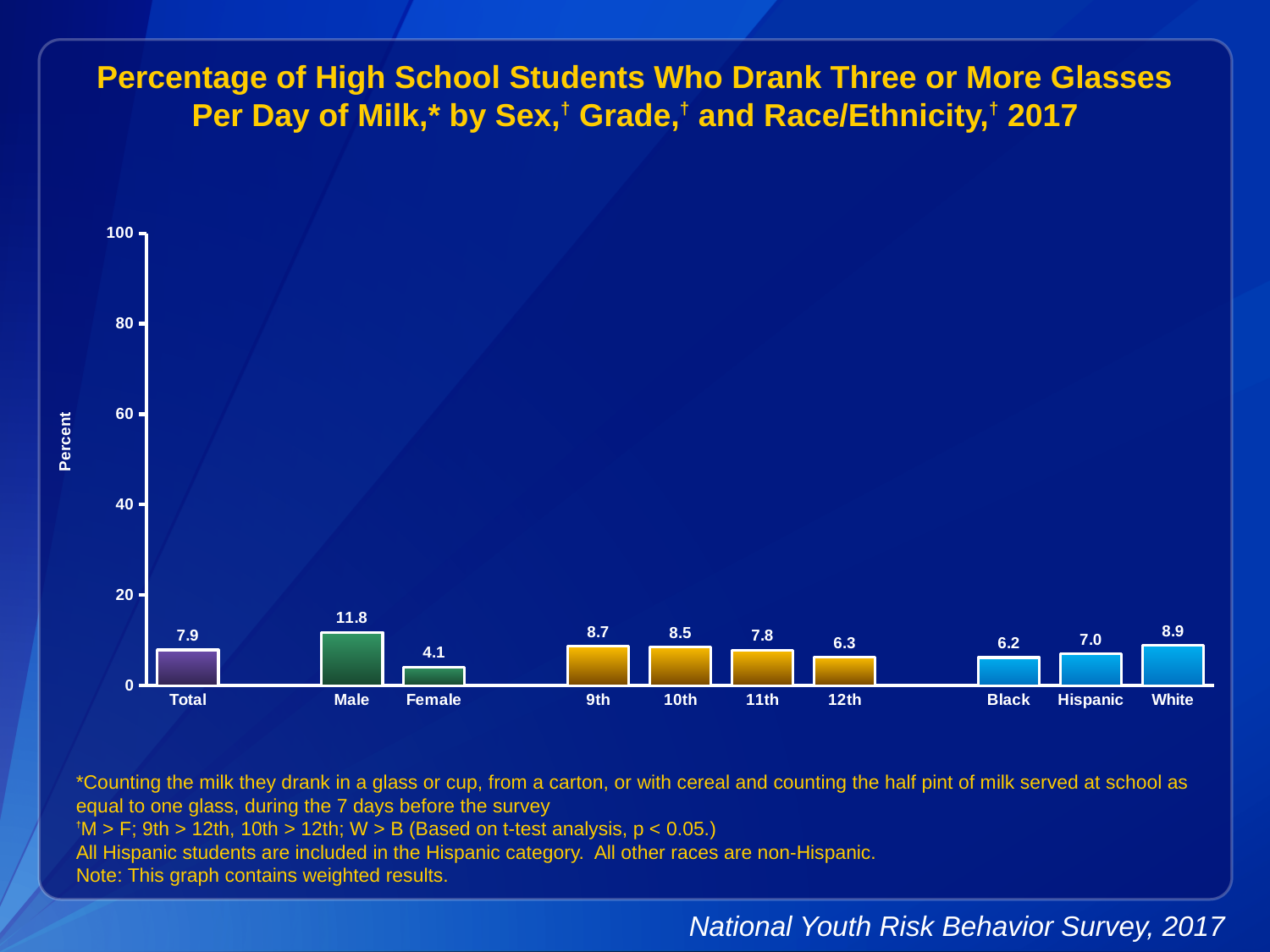
What kind of chart is this? bar chart What is the value for Male? 11.8 What is the value for 12th grade? 6.3 Which is larger, the value for White or the value for Black? White Is the value for Male greater or less than 20? less Which category has the lowest value? Female How many categories are shown on the x axis? 10 Do the values rise or fall from 9th grade to 12th grade? fall Which category has the highest value? Male What is the value for Female? 4.1 What is the value for Total? 7.9 What is the difference between the values for Male and Female? 7.7